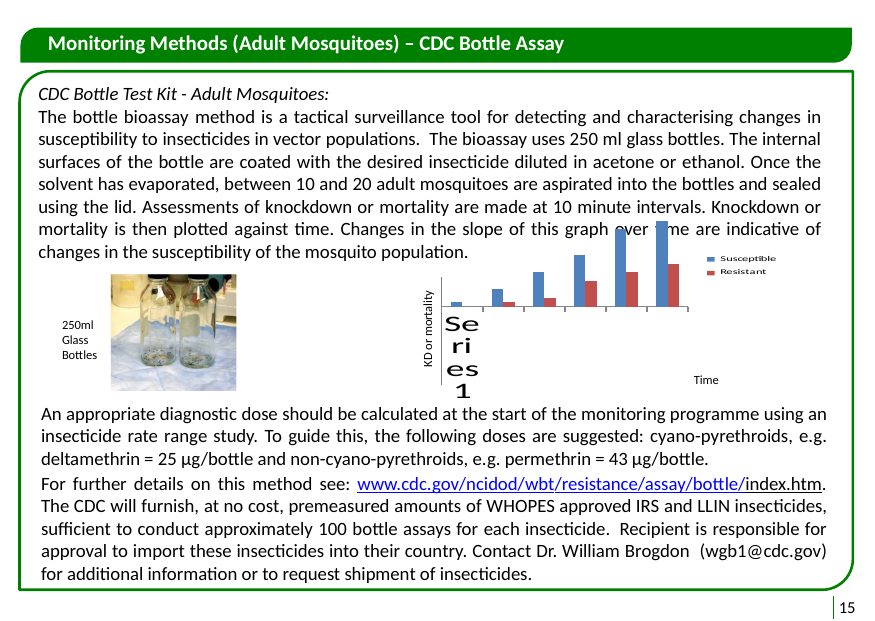
Which series reaches the highest value on the chart? Susceptible What are the two series named in the chart's legend? Susceptible and Resistant Do the Resistant bars rise or fall as you move along the Time axis? rise Do the Susceptible bars rise or fall as you move along the Time axis? rise Which series is shown in blue on the chart? Susceptible How many series does the chart's legend list? 2 In the rightmost group of bars, which series has the taller bar, Susceptible or Resistant? Susceptible What is the label on the chart's vertical axis? KD or mortality What kind of chart is shown on the slide? bar chart